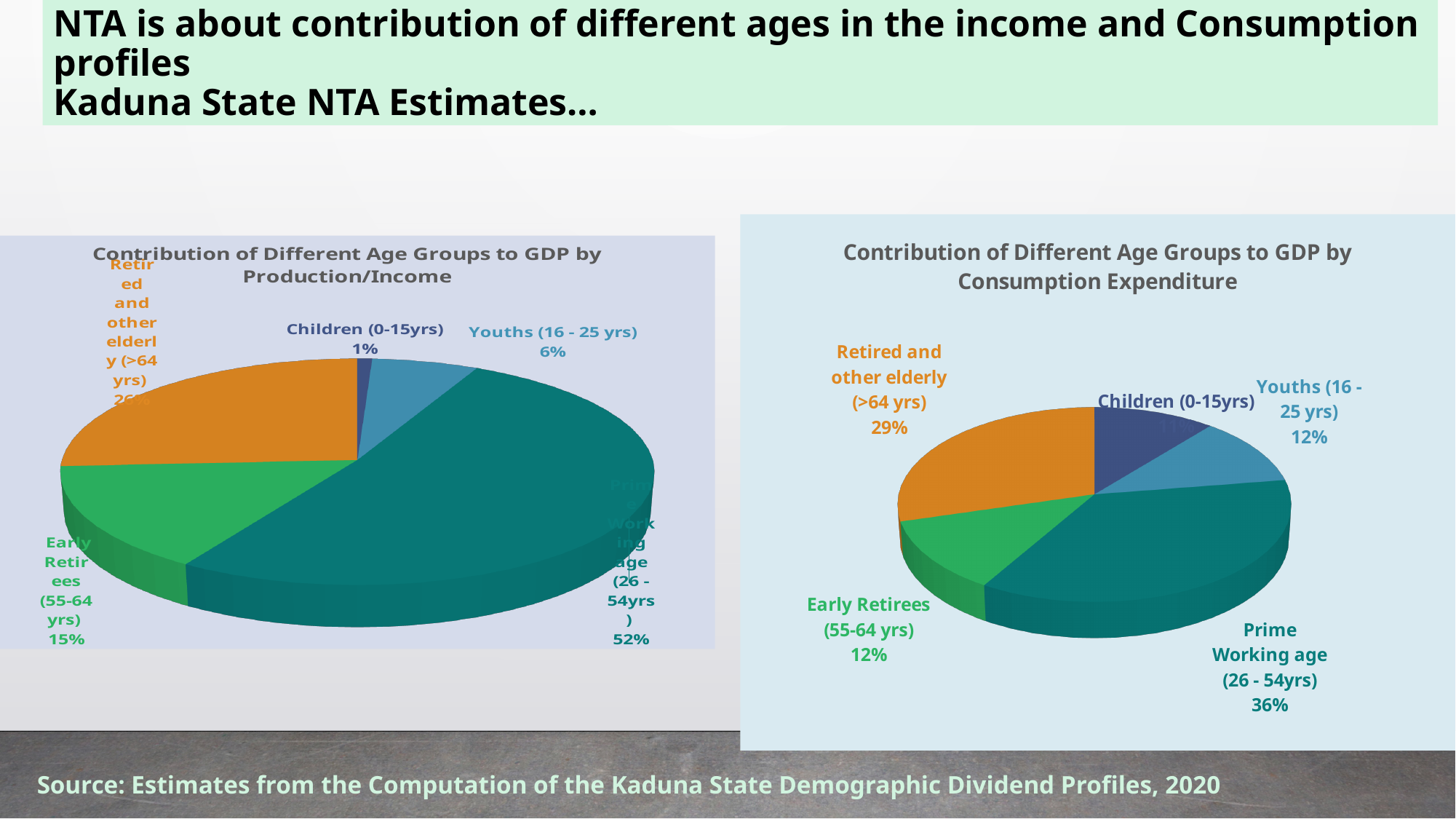
In the 'Contribution of Different Age Groups to GDP by Production/Income' chart, what share is attributed to Children (0-15yrs)? 1% In the 'Contribution of Different Age Groups to GDP by Production/Income' chart, what share is attributed to Early Retirees (55-64 yrs)? 15% In the 'Contribution of Different Age Groups to GDP by Production/Income' chart, what is the difference between the Early Retirees (55-64 yrs) share and the Youths (16 - 25 yrs) share? 9 percentage points In the 'Contribution of Different Age Groups to GDP by Production/Income' chart, what share is attributed to Prime Working age (26 - 54yrs)? 52% In the 'Contribution of Different Age Groups to GDP by Production/Income' chart, which age group has the smallest share? Children (0-15yrs) In the 'Contribution of Different Age Groups to GDP by Consumption Expenditure' chart, what share is attributed to Retired and other elderly (>64 yrs)? 29% In the 'Contribution of Different Age Groups to GDP by Consumption Expenditure' chart, what share is attributed to Prime Working age (26 - 54yrs)? 36% What kind of chart is the 'Contribution of Different Age Groups to GDP by Production/Income' chart? Pie chart In the 'Contribution of Different Age Groups to GDP by Consumption Expenditure' chart, which is larger: the share for Prime Working age (26 - 54yrs) or the share for Retired and other elderly (>64 yrs)? Prime Working age (26 - 54yrs) How many age-group slices does the 'Contribution of Different Age Groups to GDP by Consumption Expenditure' chart have? 5 In the 'Contribution of Different Age Groups to GDP by Consumption Expenditure' chart, what share is attributed to Youths (16 - 25 yrs)? 12% In the 'Contribution of Different Age Groups to GDP by Production/Income' chart, which age group has the largest share? Prime Working age (26 - 54yrs)